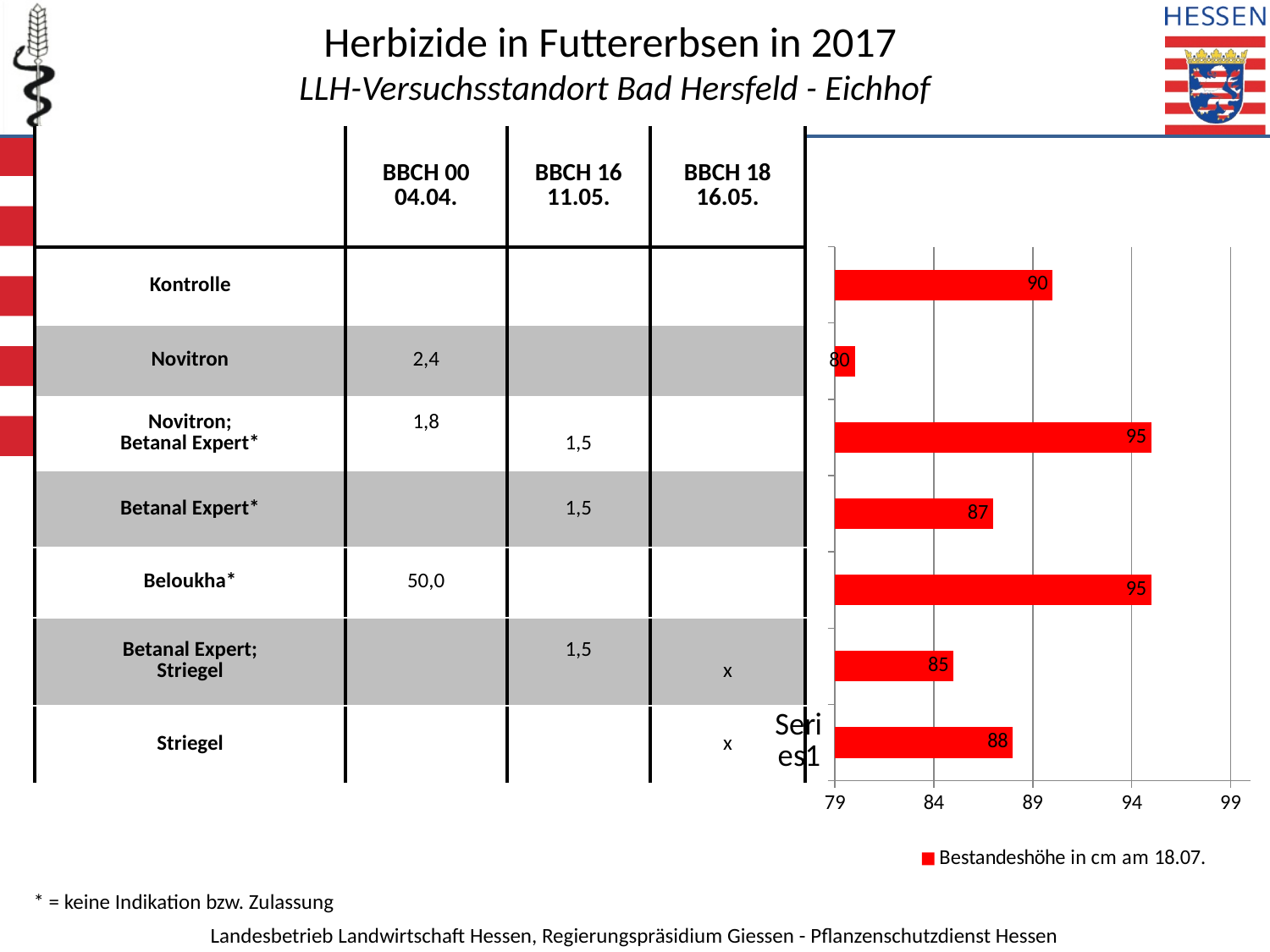
Is the Bestandeshöhe for Beloukha* greater or less than 94? greater How many series does the chart legend list? 1 What is the Bestandeshöhe in cm am 18.07. for the Betanal Expert; Striegel row? 85 What kind of chart is shown on the slide? bar chart What is the Bestandeshöhe in cm am 18.07. for the Novitron row? 80 Which has a larger Bestandeshöhe, Kontrolle or Betanal Expert*? Kontrolle What is the Bestandeshöhe in cm am 18.07. for the Striegel row? 88 How many bars are shown in the chart? 7 What is the Bestandeshöhe in cm am 18.07. for the Kontrolle row? 90 What is the highest Bestandeshöhe value shown in the bar chart? 95 Which row has the lowest Bestandeshöhe in cm am 18.07.? Novitron What is the difference between the Bestandeshöhe of Kontrolle and Novitron? 10